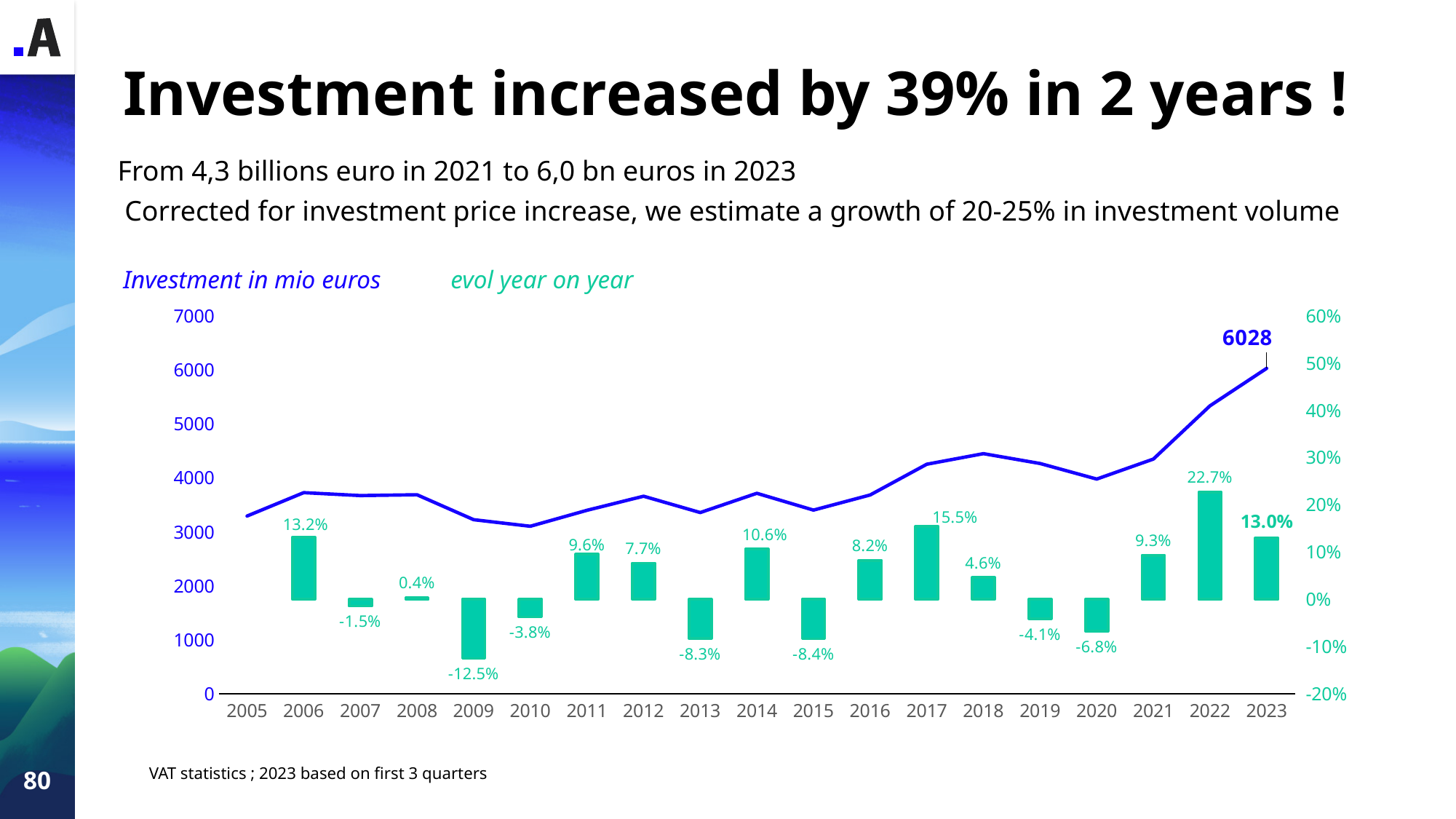
Which year has the highest year-on-year evolution bar? 2022 Which year has the larger year-on-year evolution value, 2017 or 2014? 2017 What is the year-on-year evolution value shown for 2009? -12.5% How many years are shown on the x axis of the chart? 19 Which year has the lowest year-on-year evolution bar? 2009 What investment value in mio euros is labelled on the line for 2023? 6028 What is the difference between the year-on-year evolution values for 2022 and 2023? 9.7% Does the investment line rise or fall between 2020 and 2023? rise What is the year-on-year evolution value shown for 2022? 22.7% What is the label of the series plotted as bars in the chart? evol year on year Is the investment value for 2020 greater or less than 5000 mio euros? less Is the investment value for 2022 greater or less than 5000 mio euros? greater